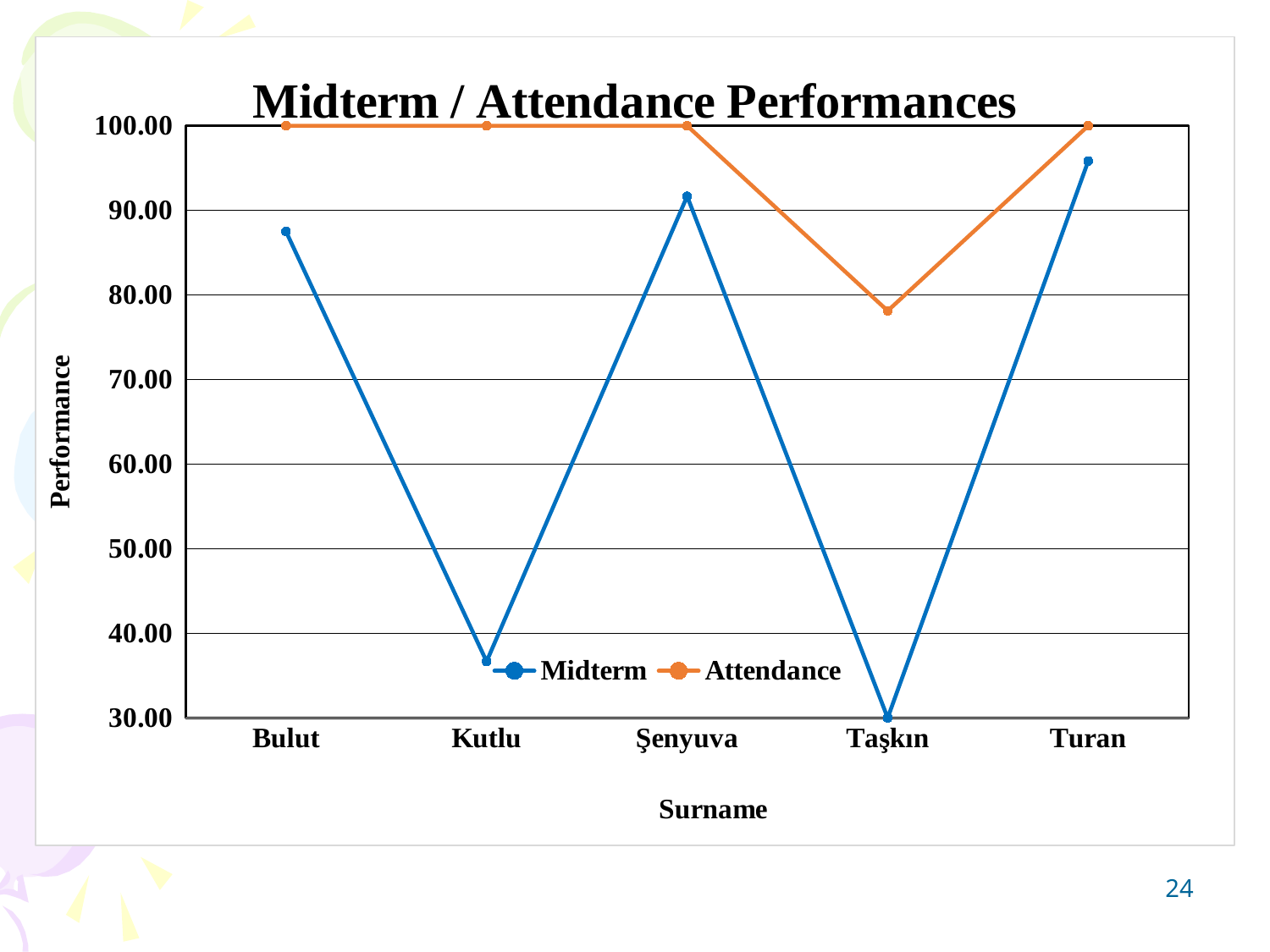
Is the Attendance value for Taşkın greater or less than 80.00? less What kind of chart is shown on the slide? line chart Is the Midterm value for Kutlu greater or less than 40.00? less How many series does the legend list? 2 What is the Attendance value for Bulut? 100.00 Which surname has the highest Midterm value? Turan How many surnames are plotted along the x axis? 5 Is the Midterm value for Şenyuva greater or less than 90.00? greater Which is larger, the Midterm value for Bulut or for Kutlu? Bulut What is the Midterm value for Taşkın? 30.00 What is the title of the chart? Midterm / Attendance Performances Which surname has the lowest Midterm value? Taşkın